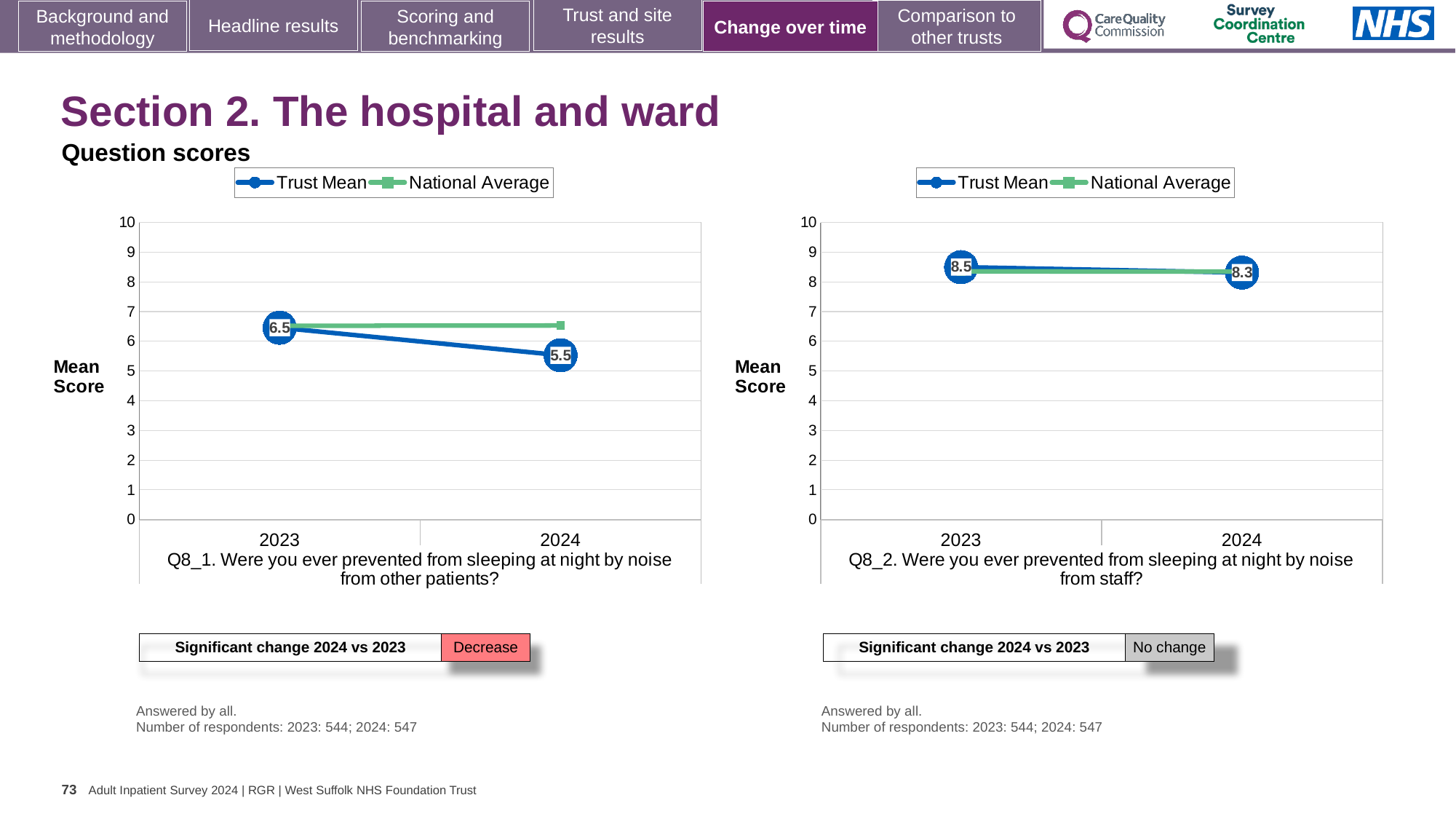
How many series does the legend of the Q8_2 chart (right) list? 2 On the Q8_2 chart (right), what is the Trust Mean score for 2024? 8.3 On the Q8_1 chart (left), by how much did the Trust Mean score fall from 2023 to 2024? 1.0 On the Q8_1 chart (left), does the Trust Mean rise or fall from 2023 to 2024? fall On the Q8_2 chart (right), what is the Trust Mean score for 2023? 8.5 On the Q8_1 chart (left), what is the Trust Mean score for 2024? 5.5 What kind of chart is the Q8_1 chart (left)? line chart On the Q8_1 chart (left), is the National Average value for 2024 greater or less than 6? greater On the Q8_1 chart (left), what is the Trust Mean score for 2023? 6.5 On the Q8_2 chart (right), what is the difference between the Trust Mean scores for 2023 and 2024? 0.2 What does the 'Significant change 2024 vs 2023' box below the Q8_1 chart (left) say? Decrease On the Q8_2 chart (right), is the National Average value for 2023 greater or less than 8? greater